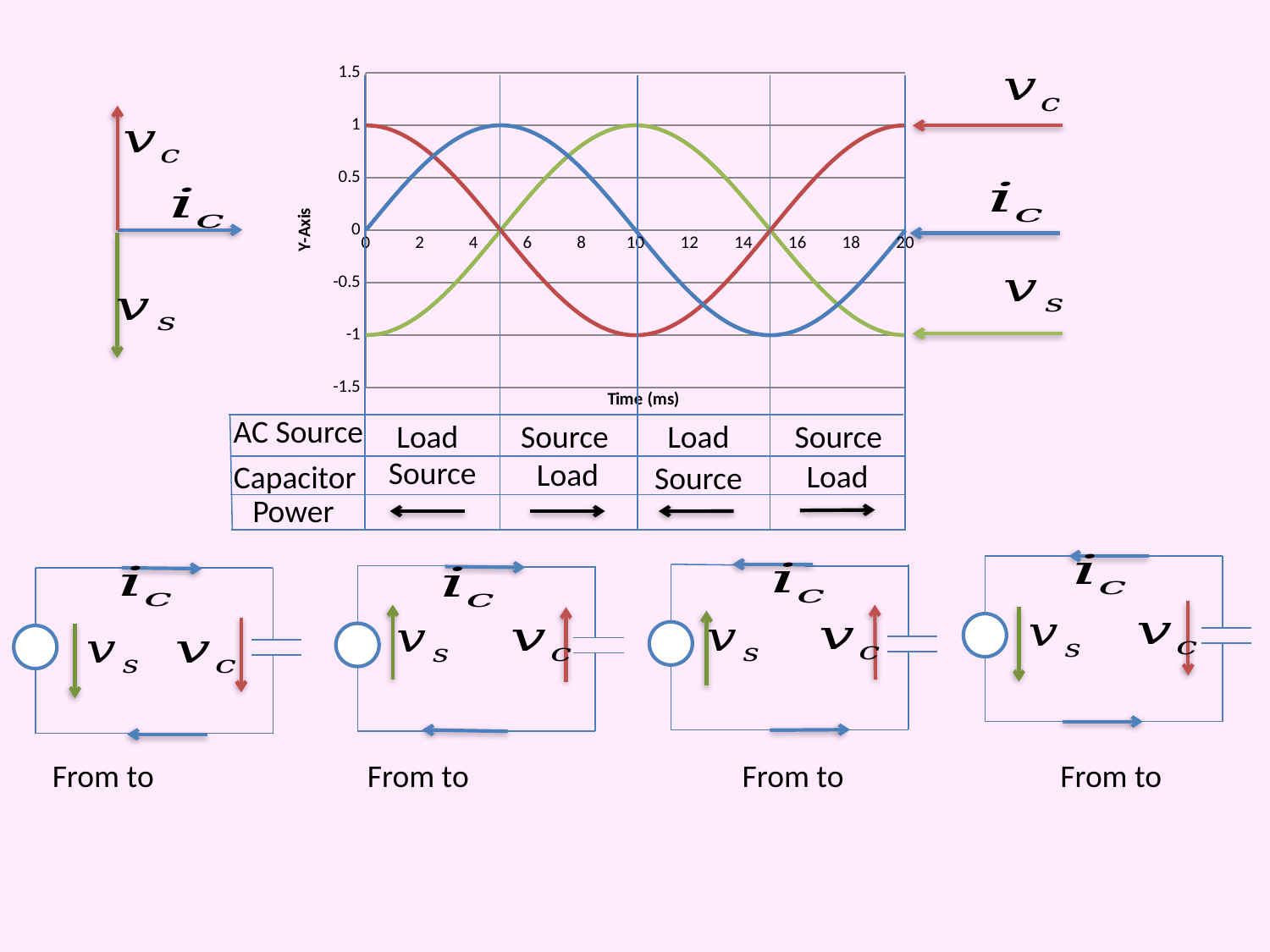
What is the value of the red v_c curve at time 10 ms? -1 Is the value of the green v_s curve at time 10 ms greater or less than 0.5? greater What is the title of the y axis of the chart? Y-Axis What is the title of the x axis of the chart? Time (ms) How many series are plotted on the chart? 3 What is the value of the red v_c curve at time 0 ms? 1 What kind of chart is shown on the slide? line chart Which curve has the higher value at time 0 ms, the red v_c curve or the green v_s curve? red v_c curve What is the value of the blue i_c curve at time 5 ms? 1 What is the value of the green v_s curve at time 0 ms? -1 Does the red v_c curve rise or fall between 0 ms and 10 ms? fall Is the value of the blue i_c curve at time 15 ms greater or less than 0? less